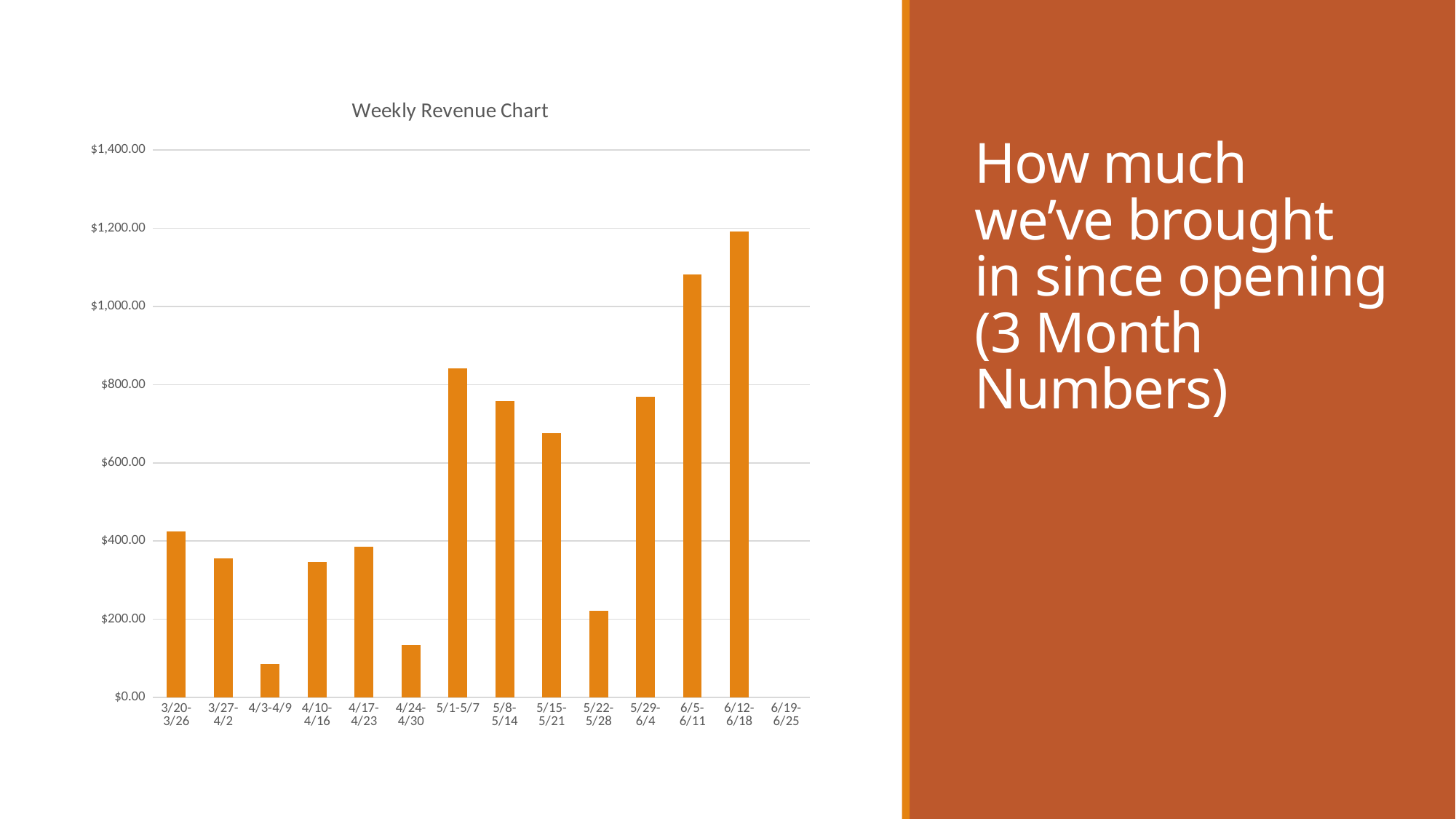
How many week categories are labelled on the x axis? 14 What is the title of the chart? Weekly Revenue Chart Do the bars rise or fall from 5/29-6/4 to 6/12-6/18? rise Among the weeks with a visible bar, which week has the shortest bar? 4/3-4/9 Which week has the higher revenue, 6/5-6/11 or 6/12-6/18? 6/12-6/18 Is the value for 6/5-6/11 greater or less than $1,000.00? greater Which week has the higher revenue, 5/1-5/7 or 5/8-5/14? 5/1-5/7 Which week has the tallest bar? 6/12-6/18 Is the value for 5/15-5/21 greater or less than $800.00? less Is the value for 5/1-5/7 greater or less than $800.00? greater What kind of chart is shown on the slide? bar chart